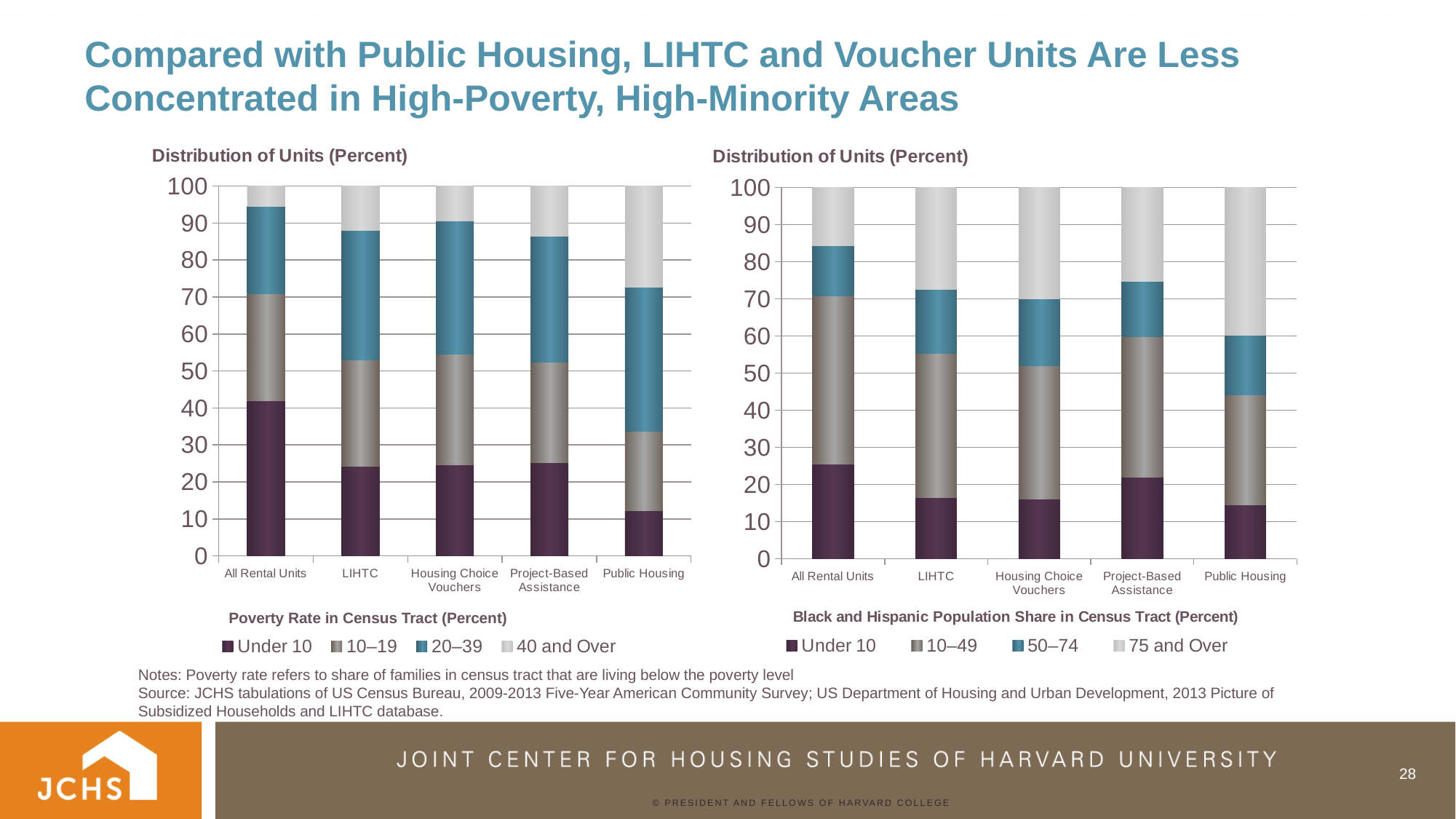
In the left chart (Poverty Rate in Census Tract), is the Under 10 value for Public Housing greater or less than 20? less How many categories are shown on the x axis of the right chart (Black and Hispanic Population Share in Census Tract)? 5 In the left chart (Poverty Rate in Census Tract), which category has the smallest Under 10 segment? Public Housing In the right chart (Black and Hispanic Population Share in Census Tract), which category has the largest 75 and Over segment? Public Housing What kind of chart is the left chart (Poverty Rate in Census Tract)? Stacked bar chart How many series does the legend of the left chart (Poverty Rate in Census Tract) list? 4 What are the legend entries of the right chart (Black and Hispanic Population Share in Census Tract)? Under 10, 10–49, 50–74, 75 and Over In the right chart (Black and Hispanic Population Share in Census Tract), is the Under 10 value for LIHTC greater or less than 20? less In the left chart (Poverty Rate in Census Tract), which category has the largest Under 10 segment? All Rental Units In the left chart (Poverty Rate in Census Tract), which has the larger Under 10 segment: All Rental Units or Public Housing? All Rental Units In the left chart (Poverty Rate in Census Tract), is the Under 10 value for All Rental Units greater or less than 40? greater